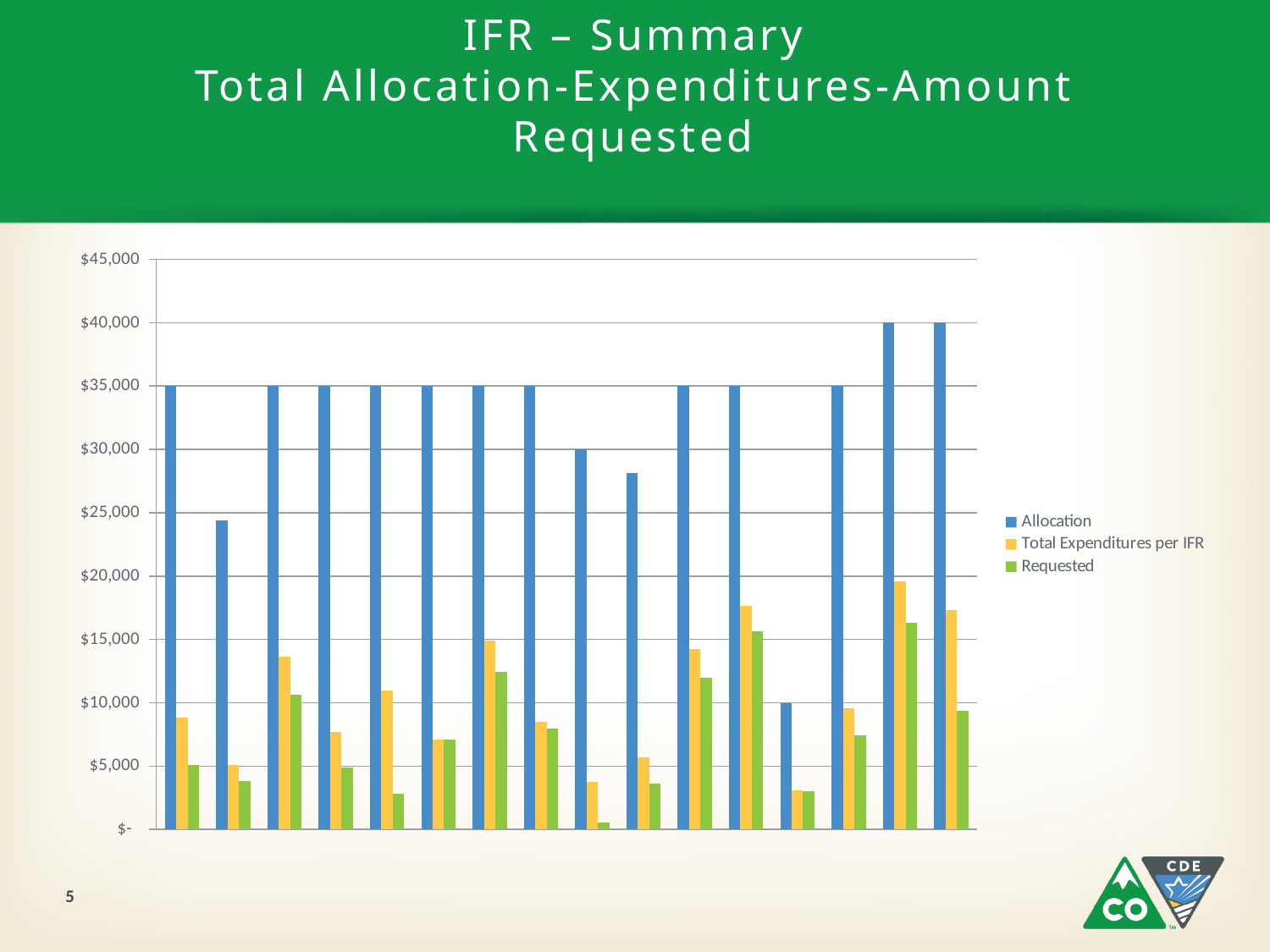
How many groups of bars are plotted along the x axis? 16 What are the three series named in the legend? Allocation, Total Expenditures per IFR, Requested What is the highest Allocation value shown on the chart? $40,000 What is the lowest Allocation value shown on the chart? $10,000 What is the Allocation value for the first group of bars from the left? $35,000 What is the Allocation value for the ninth group of bars from the left? $30,000 What is the difference between the Allocation value of the last group and the Allocation value of the first group? $5,000 What is the Allocation value for the last group of bars on the right? $40,000 What kind of chart is shown on the slide? bar chart Is the Total Expenditures per IFR value for the fifteenth group from the left greater or less than $15,000? greater Which colour represents the Allocation series? blue How many series does the legend list? 3